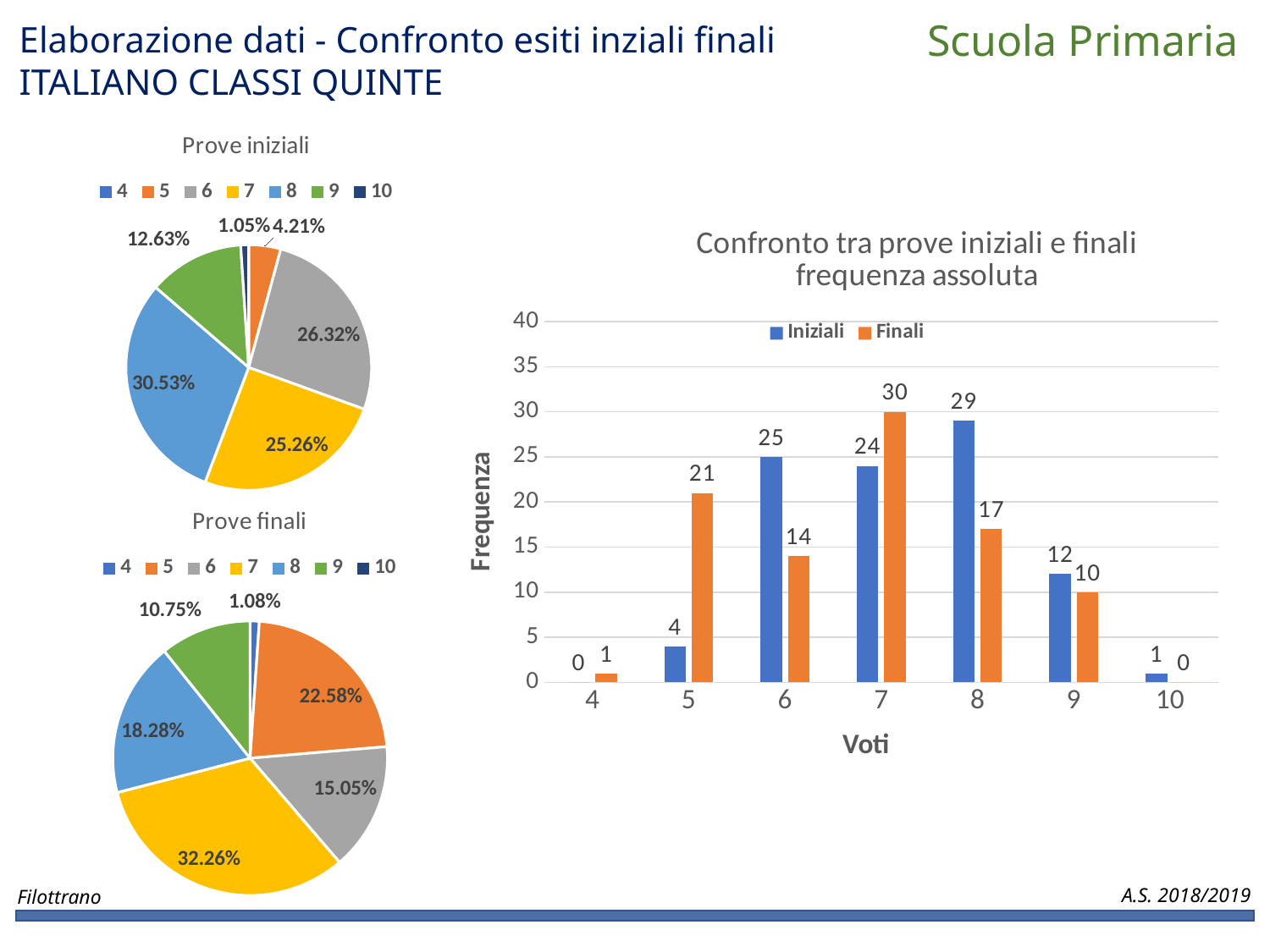
In the bar chart 'Confronto tra prove iniziali e finali frequenza assoluta', what is the difference between the Finali and Iniziali values for Voti 6? 11 In the bar chart 'Confronto tra prove iniziali e finali frequenza assoluta', what is the Finali value for Voti 5? 21 What kind of chart is the chart titled 'Confronto tra prove iniziali e finali frequenza assoluta'? Bar chart In the bar chart 'Confronto tra prove iniziali e finali frequenza assoluta', how many series does the legend list? 2 In the 'Prove finali' pie chart, what share does the slice for 7 have? 32.26% In the bar chart 'Confronto tra prove iniziali e finali frequenza assoluta', which Voti category has the highest Finali value? 7 In the 'Prove iniziali' pie chart, what share does the slice for 8 have? 30.53% In the bar chart 'Confronto tra prove iniziali e finali frequenza assoluta', how many Voti categories are shown on the x axis? 7 In the bar chart 'Confronto tra prove iniziali e finali frequenza assoluta', which is larger for Voti 9: Iniziali or Finali? Iniziali In the bar chart 'Confronto tra prove iniziali e finali frequenza assoluta', what is the Iniziali value for Voti 8? 29 In the 'Prove finali' pie chart, which category has the largest slice? 7 In the bar chart 'Confronto tra prove iniziali e finali frequenza assoluta', which Voti category has the lowest Iniziali value? 4